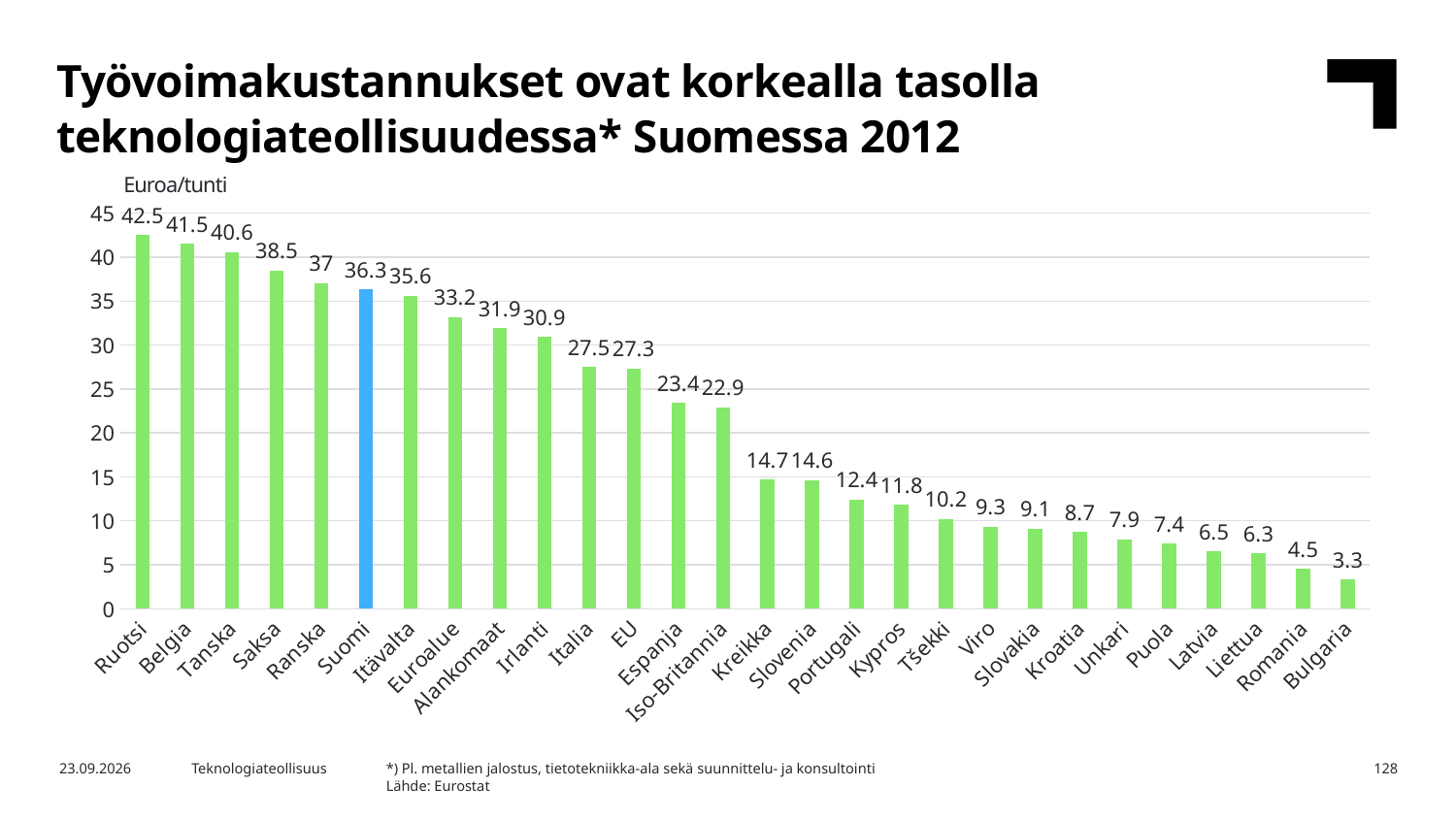
What kind of chart is shown on the slide? Bar chart Which bar is coloured blue instead of green? Suomi Which is larger, the value for Saksa or the value for Ranska? Saksa What is the difference between the values for Ruotsi and Suomi? 6.2 What is the difference between the values for Suomi and EU? 9 Which country has the highest labour cost per hour? Ruotsi What is the value for Viro? 9.3 Which country has the lowest labour cost per hour? Bulgaria What is the value for Suomi? 36.3 Do the values rise or fall from left to right along the x axis? Fall How many countries or regions are shown on the chart? 28 What is the value for EU? 27.3